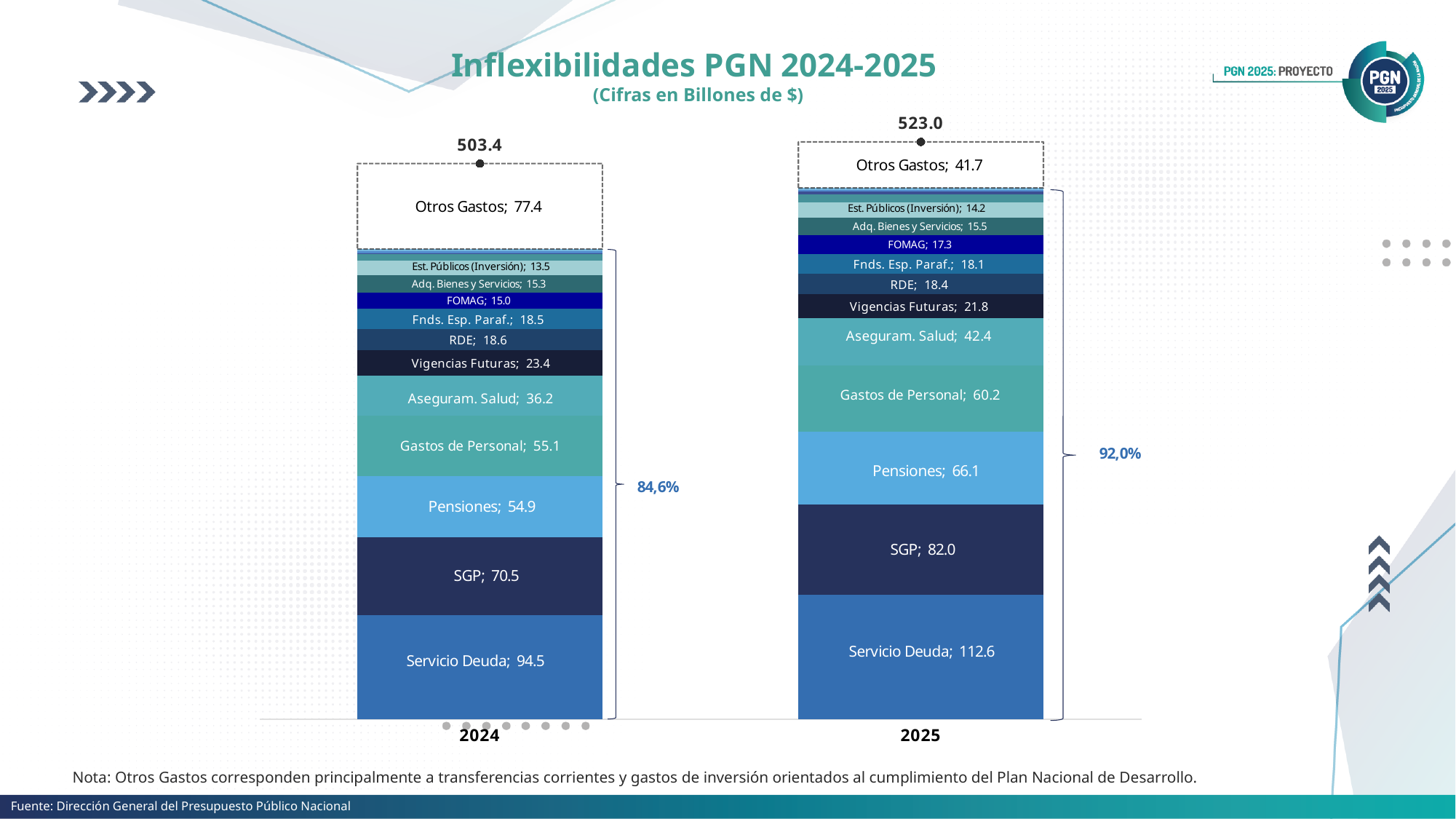
In the 2025 bar, which is larger: Pensiones or Gastos de Personal? Pensiones What is the value of Otros Gastos in the 2025 bar? 41.7 How many stacked bars does the chart show? 2 What is the total shown above the 2024 stacked bar? 503.4 What percentage is shown next to the bracket for the 2025 bar? 92,0% What is the value of Servicio Deuda in the 2024 bar? 94.5 What is the total shown above the 2025 stacked bar? 523.0 What is the difference between Otros Gastos in 2024 and Otros Gastos in 2025? 35.7 What is the value of Pensiones in the 2024 bar? 54.9 By how much does Servicio Deuda in 2025 exceed Servicio Deuda in 2024? 18.1 Which segment is the largest in the 2024 bar? Servicio Deuda What is the value of SGP in the 2025 bar? 82.0